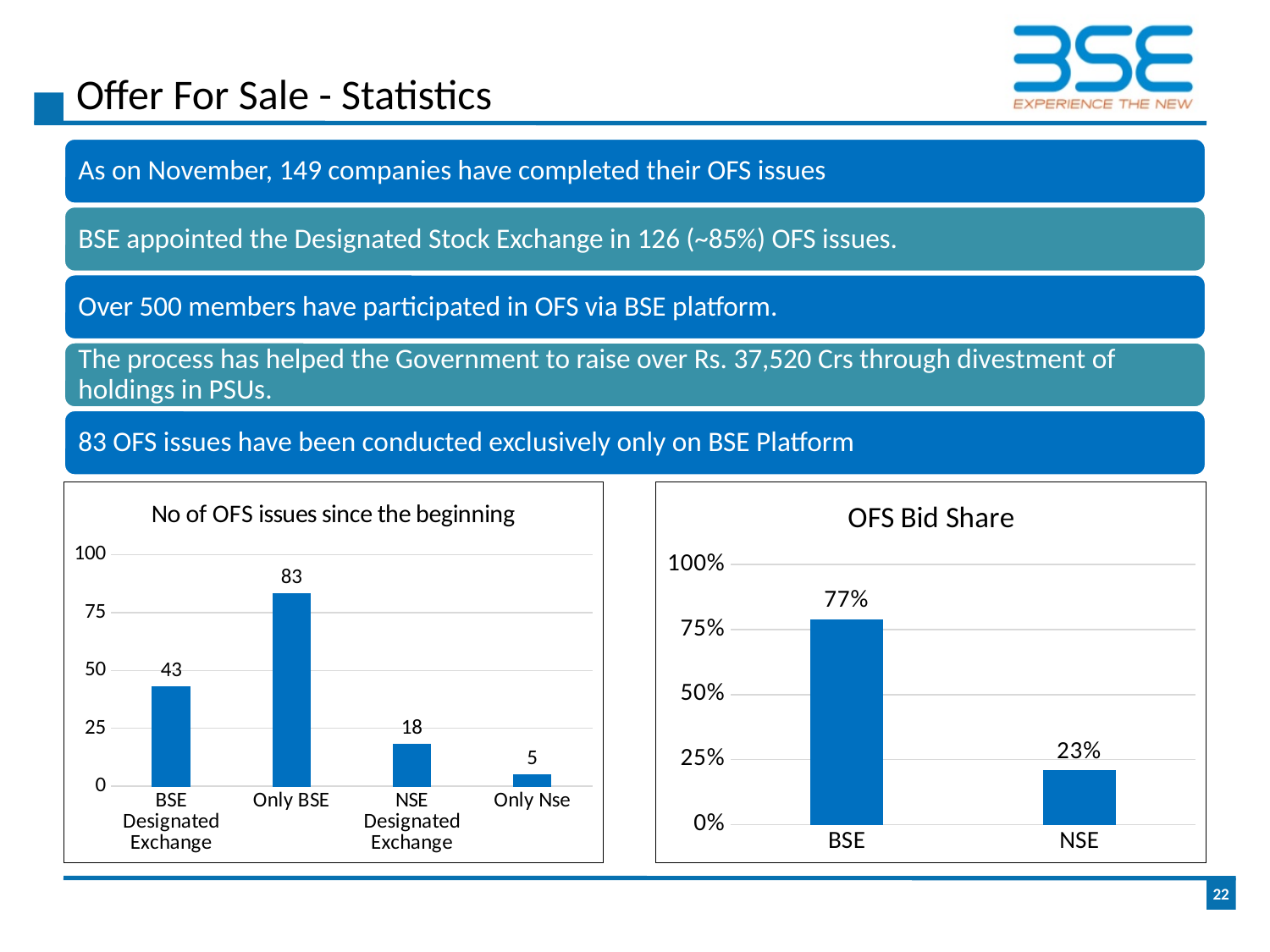
In the 'No of OFS issues since the beginning' chart, what is the difference between Only BSE and BSE Designated Exchange? 40 In the 'OFS Bid Share' chart, what is the value for BSE? 77% What kind of chart is the 'OFS Bid Share' chart? bar chart In the 'No of OFS issues since the beginning' chart, what is the value for BSE Designated Exchange? 43 In the 'OFS Bid Share' chart, which is larger, BSE or NSE? BSE In the 'OFS Bid Share' chart, what is the difference between BSE and NSE? 54% In the 'No of OFS issues since the beginning' chart, is the value for NSE Designated Exchange greater or less than 25? less In the 'OFS Bid Share' chart, what is the value for NSE? 23% In the 'No of OFS issues since the beginning' chart, how many categories are shown? 4 In the 'No of OFS issues since the beginning' chart, which category has the lowest value? Only Nse In the 'No of OFS issues since the beginning' chart, what is the value for Only BSE? 83 In the 'No of OFS issues since the beginning' chart, which category has the highest value? Only BSE